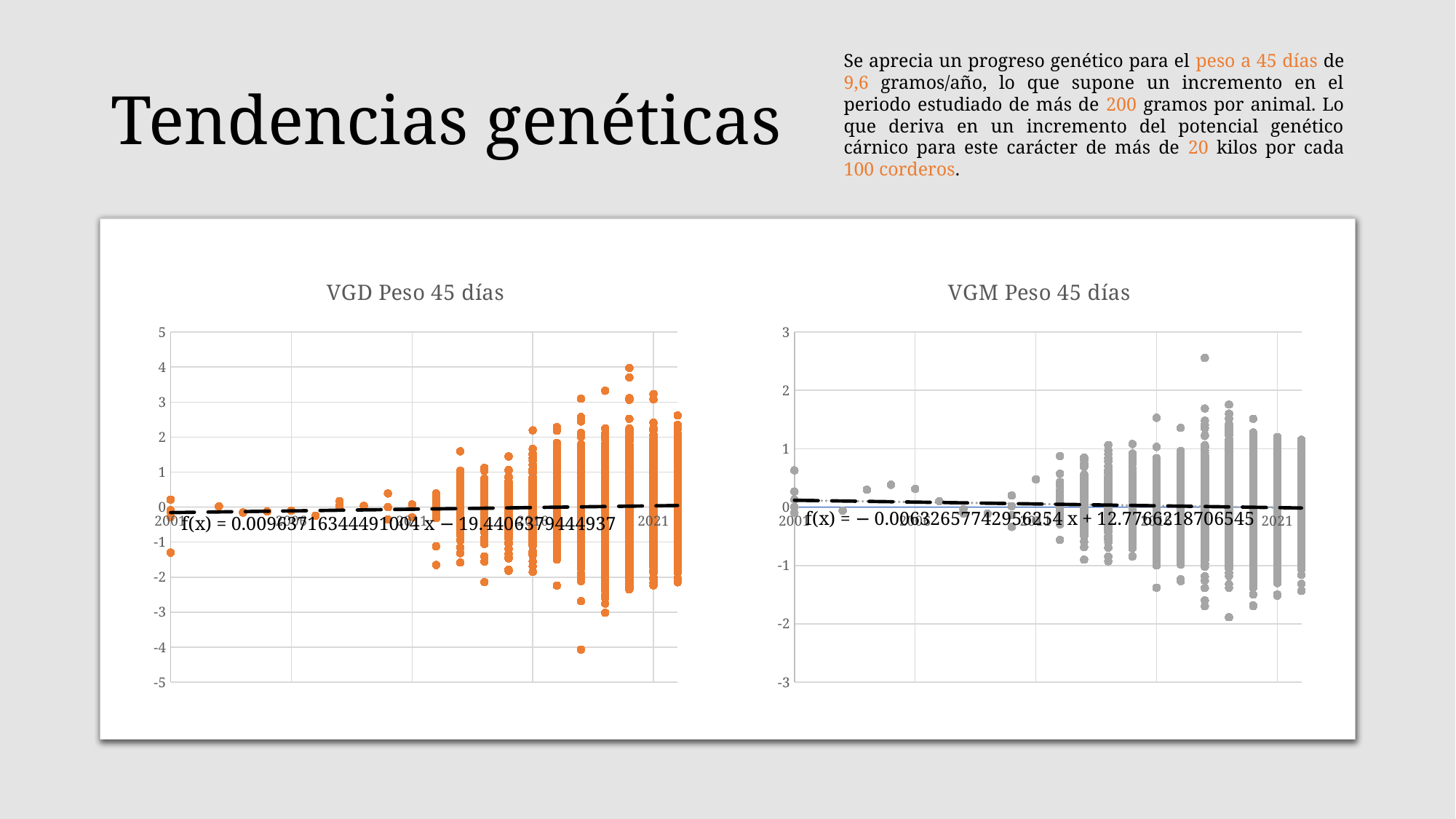
What colour are the data points in the "VGD Peso 45 días" chart? orange What kind of chart is the "VGD Peso 45 días" chart? scatter chart How many charts are shown on the slide? 2 Which chart has the wider vertical axis range, "VGD Peso 45 días" or "VGM Peso 45 días"? VGD Peso 45 días In the "VGD Peso 45 días" chart, is the highest plotted point greater or less than 3? greater In the "VGD Peso 45 días" chart, does the dashed trend line rise or fall from 2001 to 2021? rise In the "VGM Peso 45 días" chart, does the dashed trend line rise or fall from 2001 to 2021? fall In the "VGD Peso 45 días" chart, is the lowest plotted point greater or less than -3? less In the "VGD Peso 45 días" chart, what is the highest value shown on the vertical axis? 5 In the "VGM Peso 45 días" chart, what is the lowest value shown on the vertical axis? -3 In the "VGM Peso 45 días" chart, is the highest plotted point greater or less than 2? greater What is the title of the chart on the right? VGM Peso 45 días